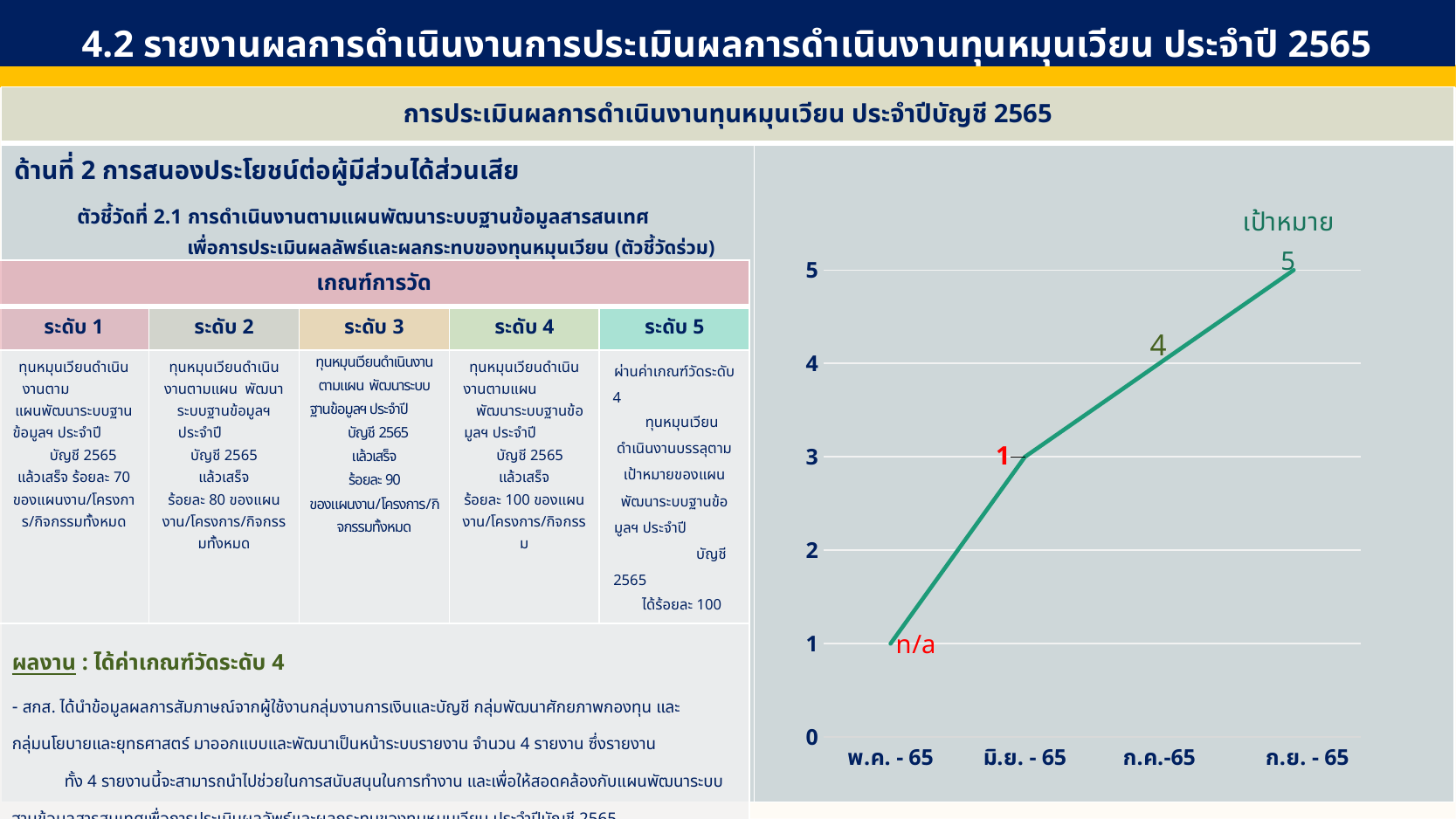
Which is larger on the line chart, the value for ก.ค.-65 or the value for ก.ย. - 65? ก.ย. - 65 Do the values on the line chart rise or fall from พ.ค. - 65 to ก.ย. - 65? rise What kind of chart is shown on the right side of the slide? line chart Which month has the lowest value on the line chart? พ.ค. - 65 What colour is the line in the chart? green What is the difference between the values for ก.ย. - 65 and ก.ค.-65 on the line chart? 1 What is the value plotted for ก.ค.-65 on the line chart? 4 How many data points are plotted on the line chart? 4 Is the value for มิ.ย. - 65 on the line chart greater or less than 2? greater What is the value plotted for ก.ย. - 65 on the line chart? 5 Which month has the highest value on the line chart? ก.ย. - 65